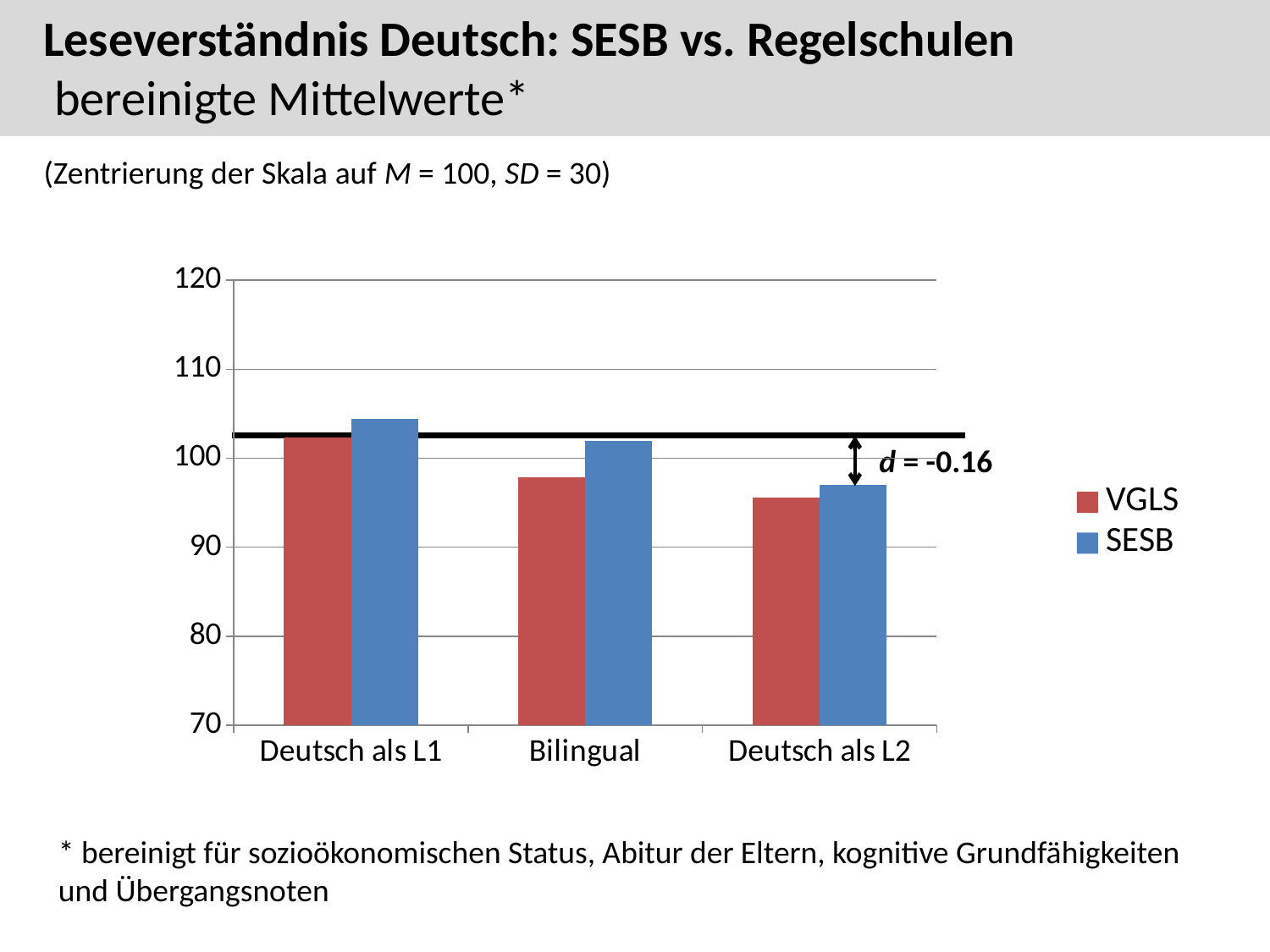
Is the SESB value for Bilingual greater or less than 100? greater How many categories are shown on the x axis? 3 What kind of chart is shown on the slide? bar chart For Bilingual, which series has the larger value, VGLS or SESB? SESB What effect size is annotated next to the arrow on the chart? d = -0.16 Is the VGLS value for Deutsch als L2 greater or less than 100? less Which series does the legend list first? VGLS How many series does the legend list? 2 For which category is the SESB bar highest? Deutsch als L1 For which category is the VGLS bar lowest? Deutsch als L2 Is the VGLS value for Bilingual greater or less than 100? less